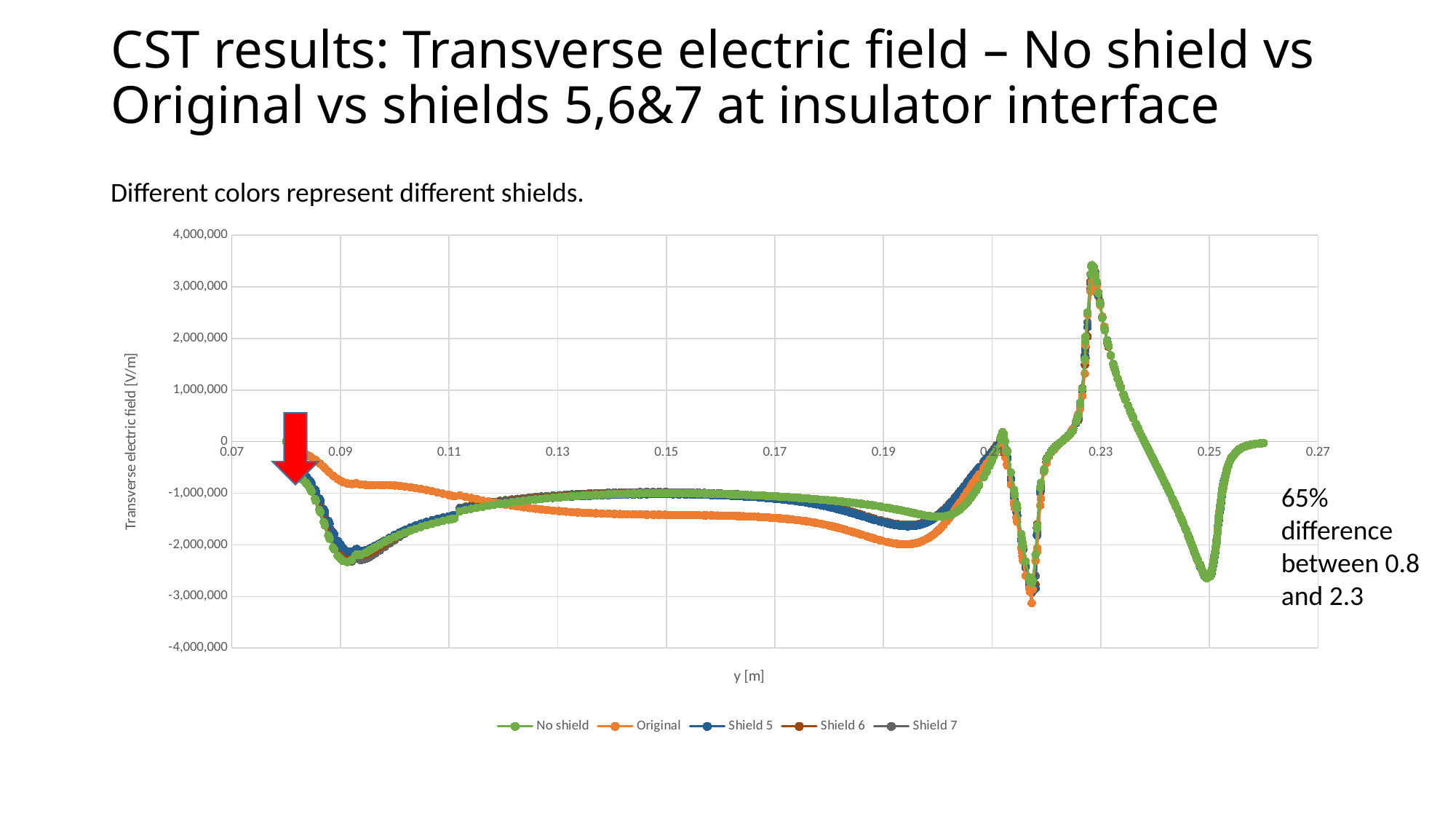
Do the values of the curves rise or fall along the x axis between y = 0.23 and y = 0.25? fall What are the series names listed in the chart legend? No shield, Original, Shield 5, Shield 6, Shield 7 Does the No shield series rise or fall along the x axis between y = 0.09 and y = 0.15? rise Is the peak value of the No shield series near y = 0.23 greater or less than 3,000,000? greater What is the label of the x axis of the chart? y [m] Is the minimum value of the curves near y = 0.25 greater or less than -2,000,000? less How many series does the chart legend list? 5 How many tick labels are shown on the x axis of the chart? 11 What kind of chart is shown on the slide? Line chart Is the value of the No shield series at y = 0.15 greater or less than -2,000,000? greater At y = 0.19, which series has the lower value, Original or No shield? Original